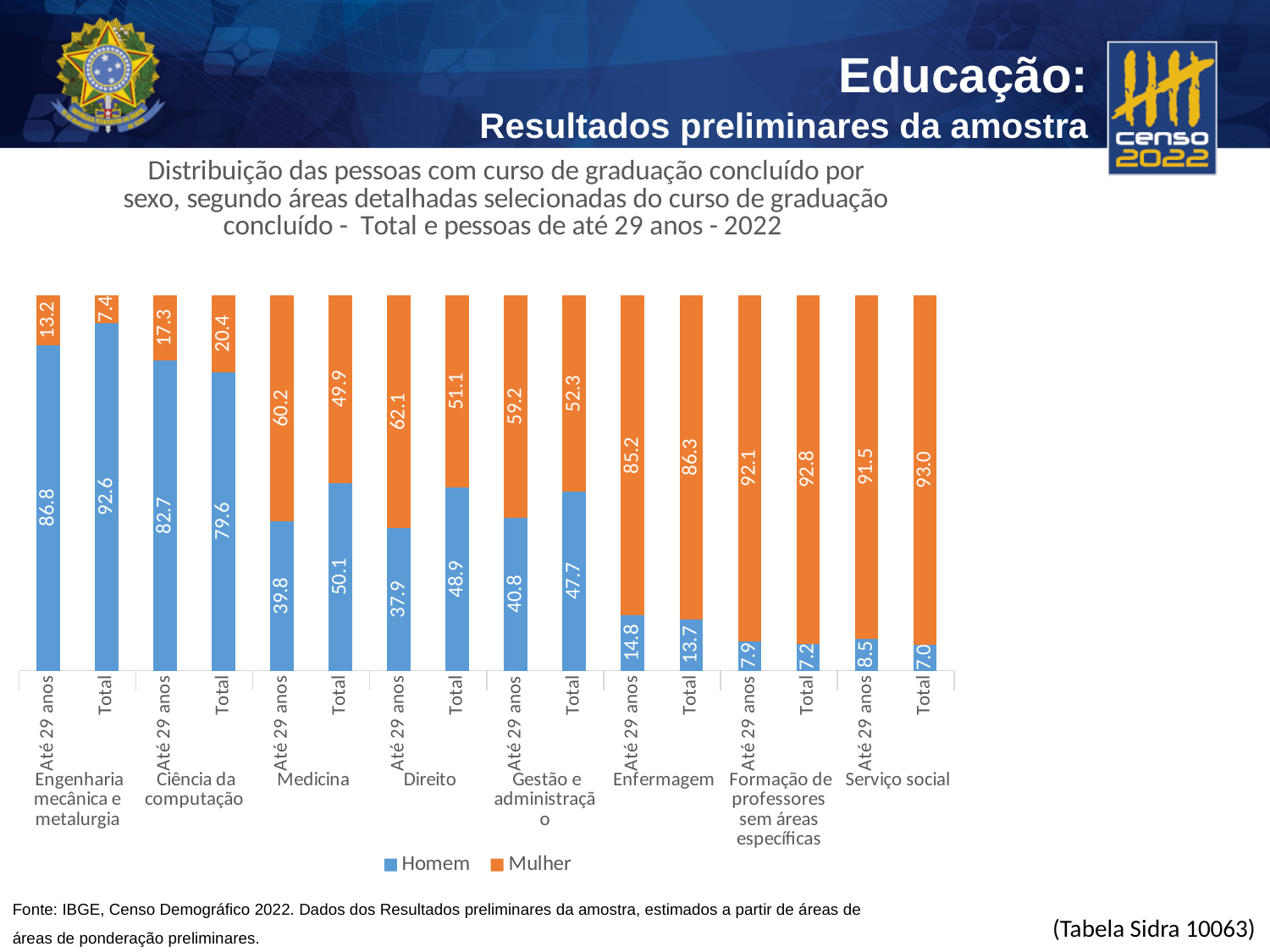
Which bar has the lowest Homem value? Serviço social, Total Which bar has the highest Mulher value? Serviço social, Total Which is larger: the Mulher value for Gestão e administração Até 29 anos or for Gestão e administração Total? Gestão e administração Até 29 anos What is the Mulher value for Direito, Até 29 anos? 62.1 What is the total of the stacked bar for Formação de professores sem áreas específicas, Até 29 anos? 100.0 What kind of chart is shown on the slide? Stacked bar chart What is the Homem value for Enfermagem, Total? 13.7 How many series does the legend list? 2 What is the Mulher value for Medicina, Total? 49.9 How many bars are plotted in the chart? 16 What is the difference between the Homem values for Ciência da computação Até 29 anos and Ciência da computação Total? 3.1 What is the Homem value for Engenharia mecânica e metalurgia, Até 29 anos? 86.8